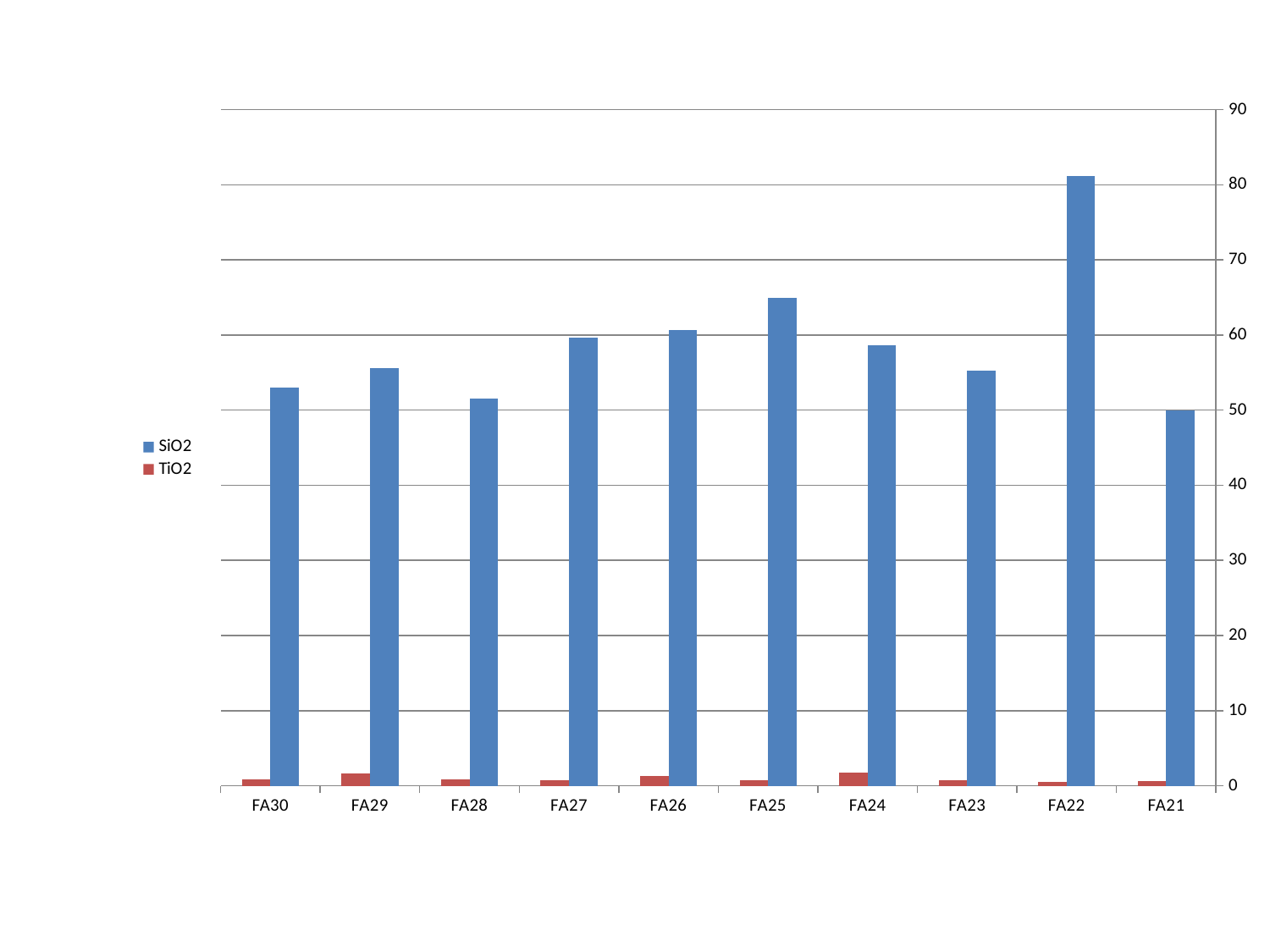
Which series is shown in blue? SiO2 Is the SiO2 value for FA21 greater or less than 60? less Which has the larger SiO2 value, FA27 or FA28? FA27 Is the SiO2 value for FA25 greater or less than 60? greater How many categories are shown on the x axis? 10 How many series does the legend list? 2 Which has the larger SiO2 value, FA25 or FA30? FA25 Which category has the highest SiO2 value? FA22 Is the SiO2 value for FA30 greater or less than 60? less What kind of chart is shown on the slide? bar chart